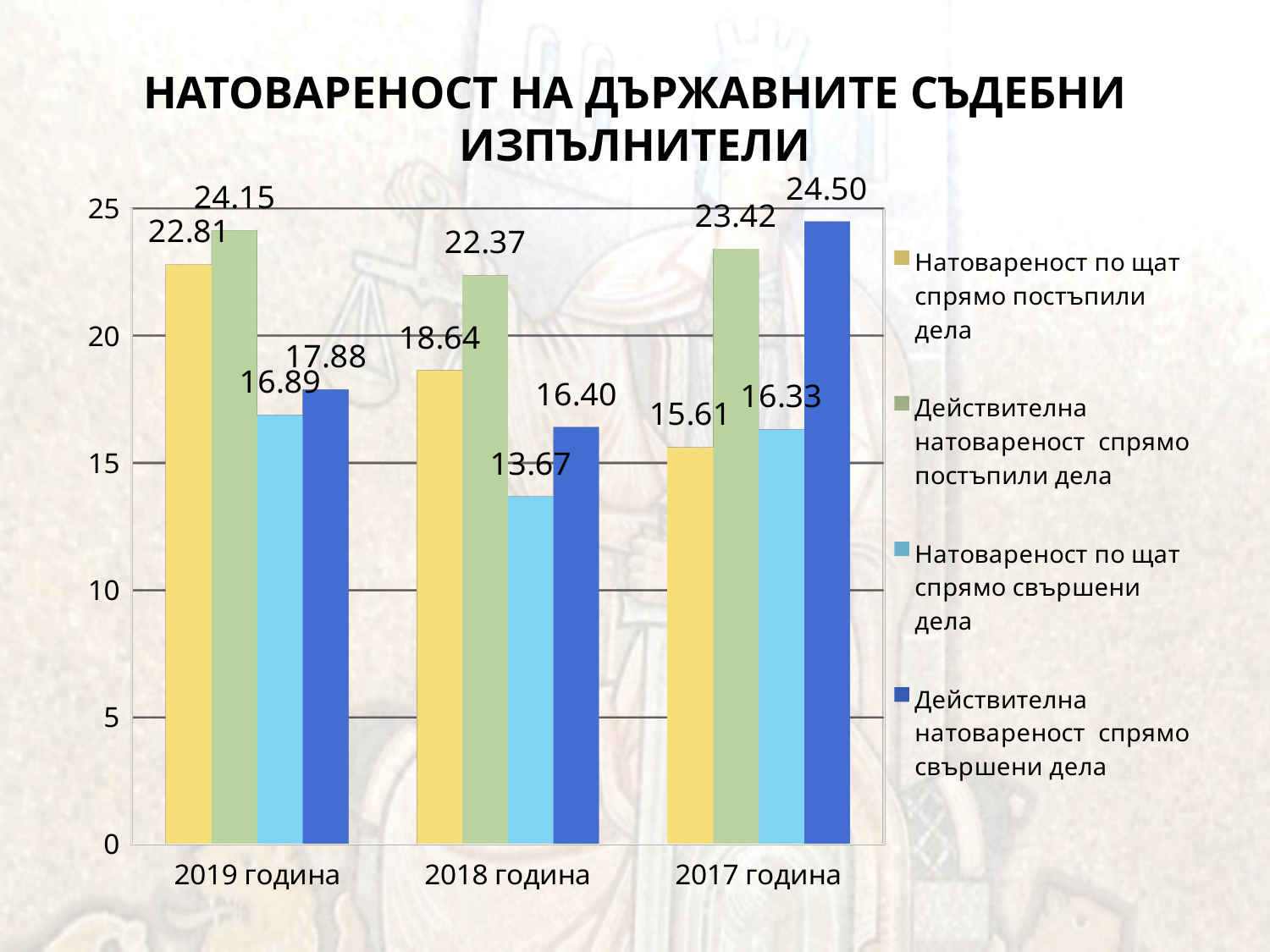
What is the difference between "Действителна натовареност спрямо постъпили дела" and "Натовареност по щат спрямо постъпили дела" for 2018 година? 3.73 Which year has the lowest value for "Натовареност по щат спрямо постъпили дела"? 2017 година Which year has the highest value for "Действителна натовареност спрямо постъпили дела"? 2019 година Is the value of "Натовареност по щат спрямо свършени дела" for 2019 година greater or less than 15? greater What is the value of "Натовареност по щат спрямо постъпили дела" for 2019 година? 22.81 Does the value of "Натовареност по щат спрямо постъпили дела" rise or fall from 2019 година to 2017 година along the x axis? Fall How many years are shown on the x axis? 3 Which is larger for 2017 година: "Натовареност по щат спрямо постъпили дела" or "Натовареност по щат спрямо свършени дела"? Натовареност по щат спрямо свършени дела How many series does the legend list? 4 What kind of chart is shown on the slide? Bar chart What is the value of "Действителна натовареност спрямо свършени дела" for 2017 година? 24.50 What is the value of "Натовареност по щат спрямо свършени дела" for 2018 година? 13.67